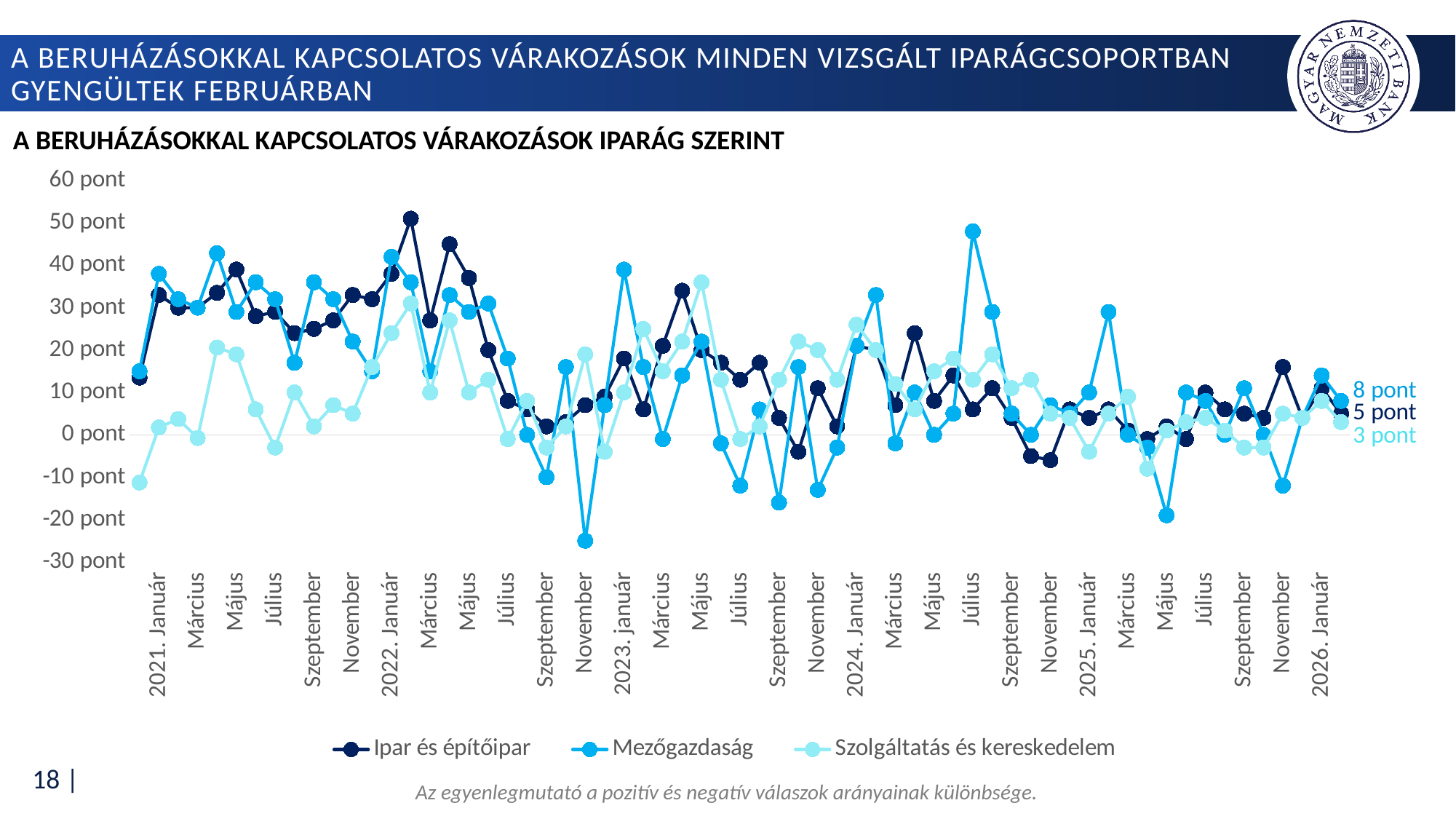
At the end of the chart, which is larger: the Mezőgazdaság value or the Ipar és építőipar value? Mezőgazdaság Which series has the highest value at the end of the chart? Mezőgazdaság What is the title of the chart? A beruházásokkal kapcsolatos várakozások iparág szerint Which series has the lowest value at the end of the chart? Szolgáltatás és kereskedelem Is the Mezőgazdaság value in July 2024 greater or less than 40 pont? greater What is the latest value shown for the Ipar és építőipar series? 5 pont What is the difference between the latest values of Mezőgazdaság and Szolgáltatás és kereskedelem? 5 pont What is the latest value shown for the Mezőgazdaság series? 8 pont Is the Mezőgazdaság value in November 2022 greater or less than -20 pont? less What is the latest value shown for the Szolgáltatás és kereskedelem series? 3 pont What kind of chart is shown on the slide? line chart How many series does the legend list? 3